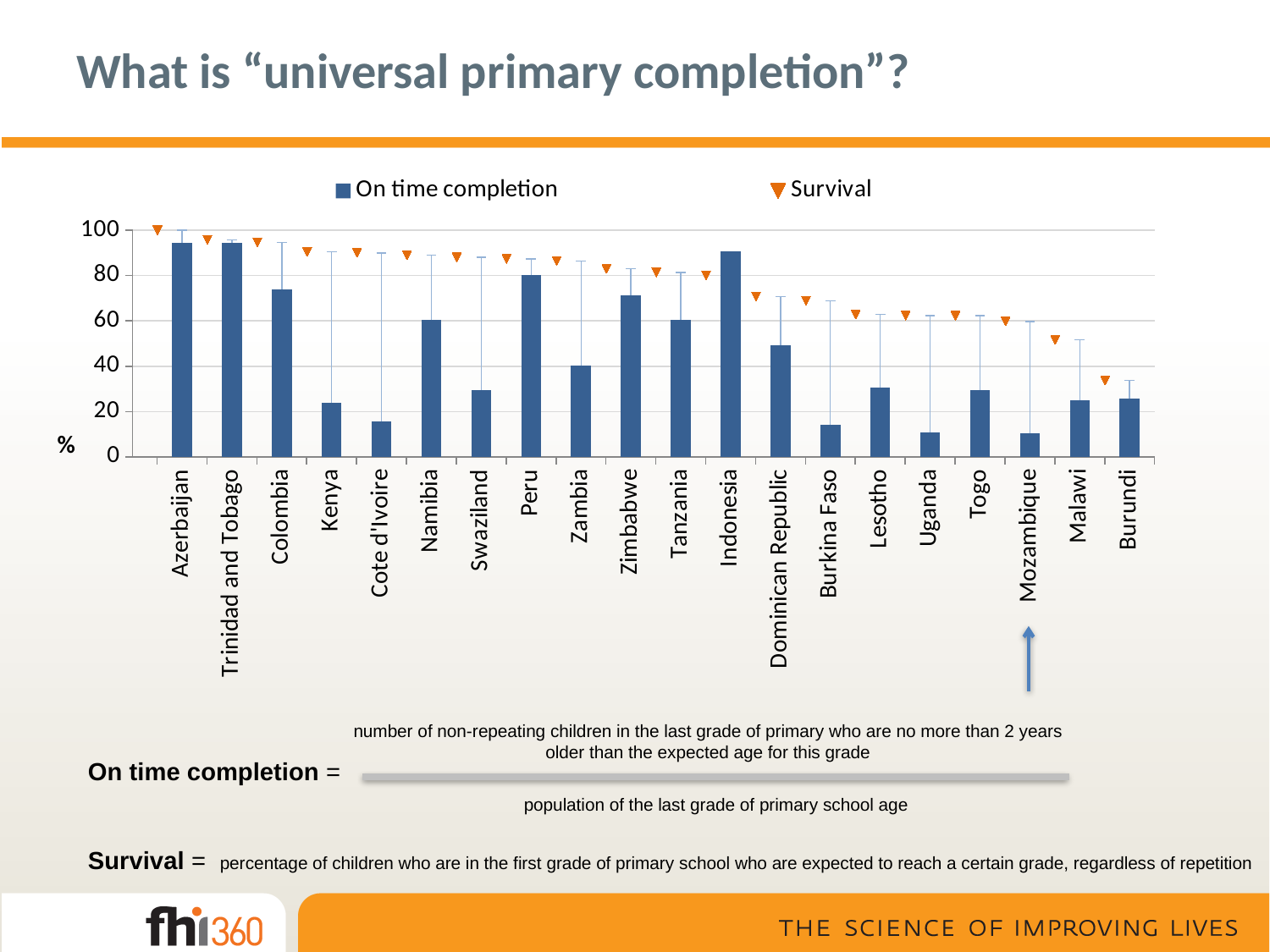
Is the On time completion value for Colombia greater or less than 60? greater Is the Survival value for Burundi greater or less than 40? less Is the On time completion value for Burkina Faso greater or less than 20? less Which country does the blue arrow below the x axis point to? Mozambique How many countries are shown on the x axis of the chart? 20 Which has the higher On time completion value, Peru or Zambia? Peru What kind of chart is shown on the slide? bar chart Which series is shown with orange triangle markers? Survival How many series does the chart legend list? 2 Which has the higher On time completion value, Cote d'Ivoire or Namibia? Namibia